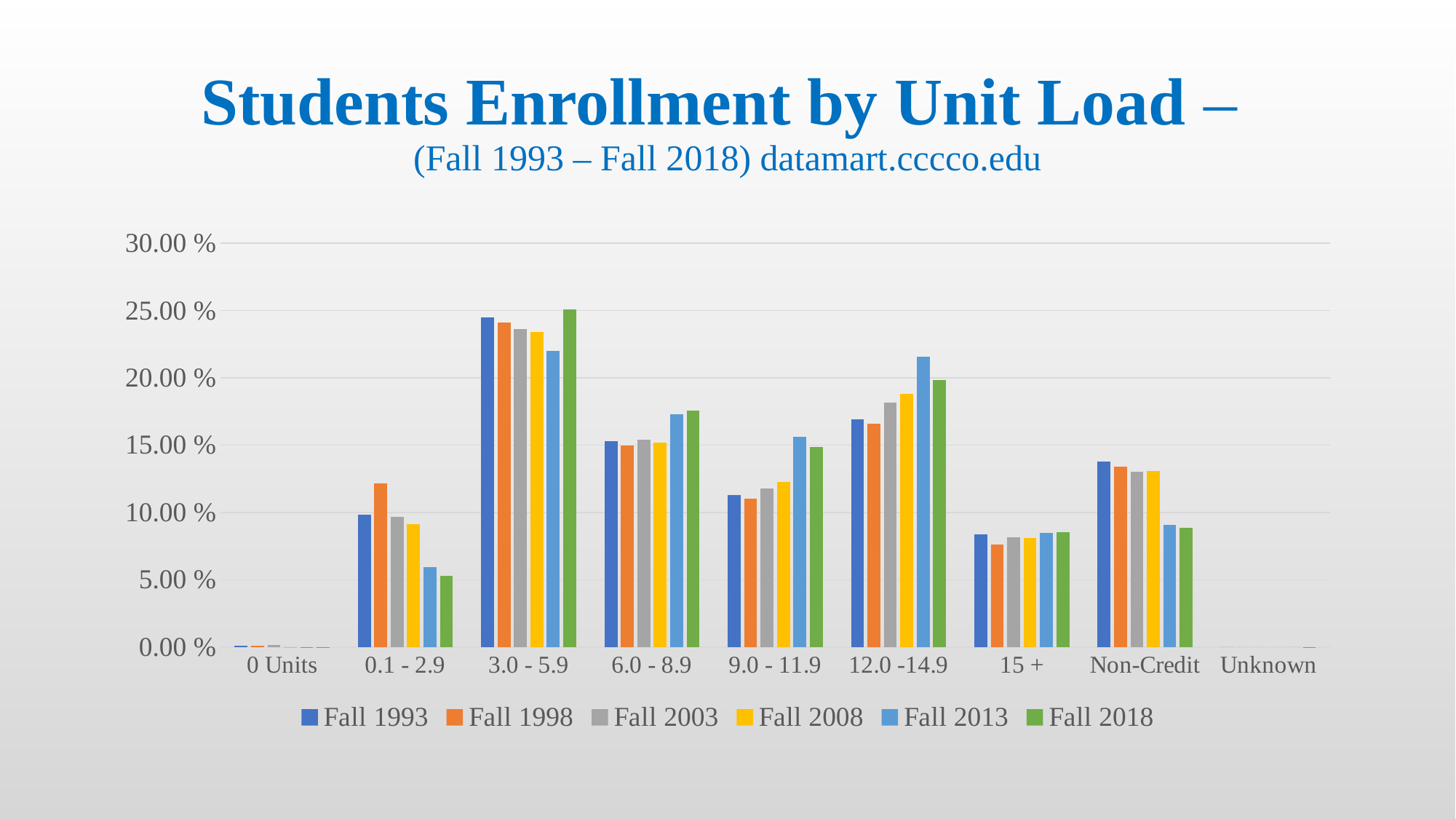
What kind of chart is shown on the slide? bar chart Which unit-load category has the highest value for Fall 2018? 3.0 - 5.9 Is the Fall 2013 value for 12.0 -14.9 greater or less than 20.00 %? greater Is the Fall 2018 value for Non-Credit greater or less than 10.00 %? less What colour represents Fall 2018 in the legend? green Is the Fall 1998 value for 0.1 - 2.9 greater or less than 10.00 %? greater In the 6.0 - 8.9 category, which is larger: Fall 1993 or Fall 2013? Fall 2013 How many unit-load categories are shown on the x axis? 9 For the Non-Credit category, do the values generally rise or fall from Fall 1993 to Fall 2018? fall How many series does the legend list? 6 In the 0.1 - 2.9 category, which is larger: Fall 1998 or Fall 2018? Fall 1998